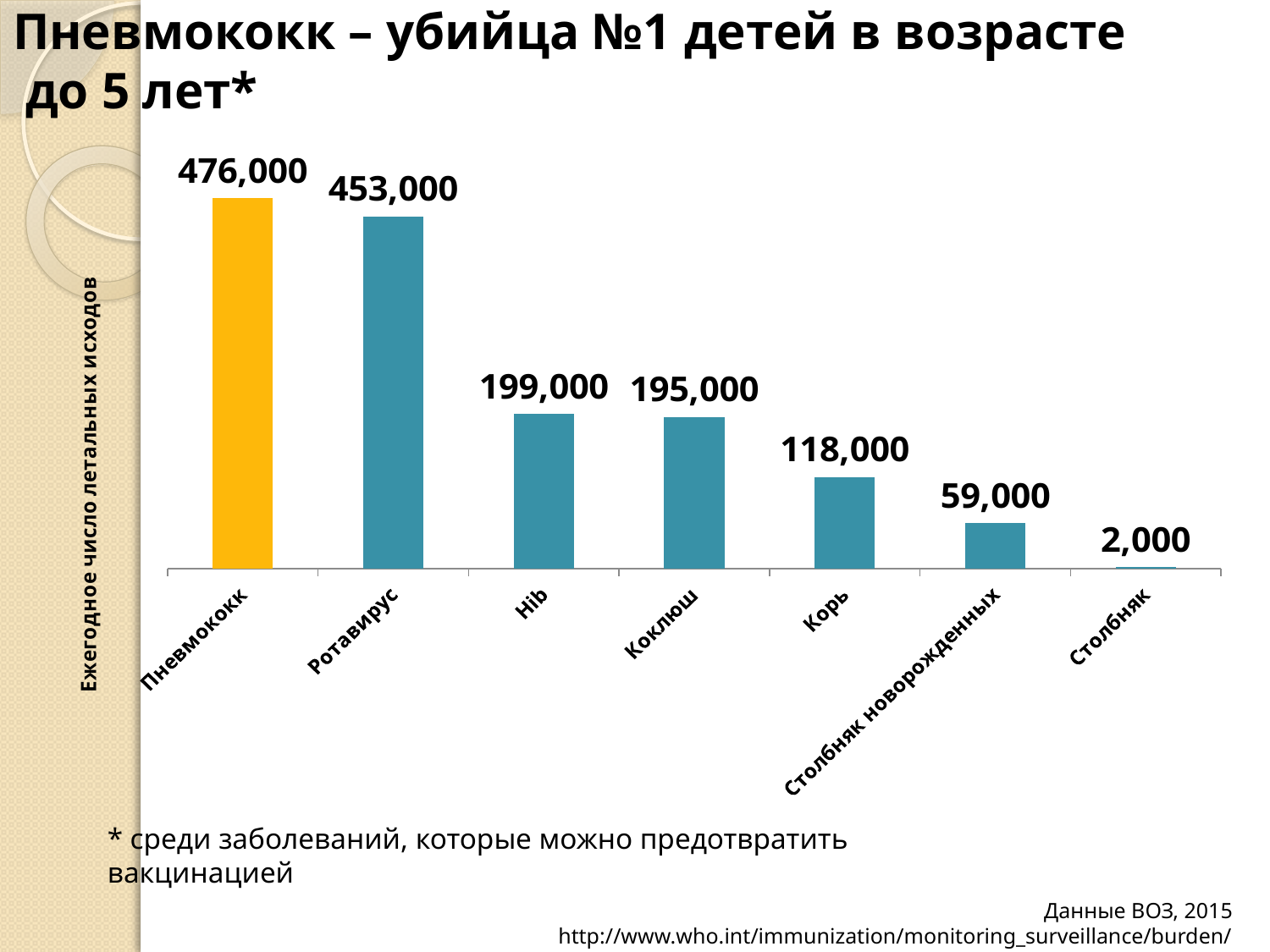
Which category has the highest value? Пневмококк Which category has the lowest value? Столбняк What kind of chart is shown on the slide? Bar chart What is the difference between the values for Пневмококк and Ротавирус? 23,000 Which bar is coloured differently (orange) from the others? Пневмококк What value is shown for Столбняк новорожденных? 59,000 What value is shown for Ротавирус? 453,000 What value is shown for Hib? 199,000 What is the annual number of deaths shown for Пневмококк? 476,000 How many categories are shown on the x axis? 7 What is the difference between the values for Корь and Столбняк новорожденных? 59,000 Which is larger, the value for Hib or the value for Коклюш? Hib